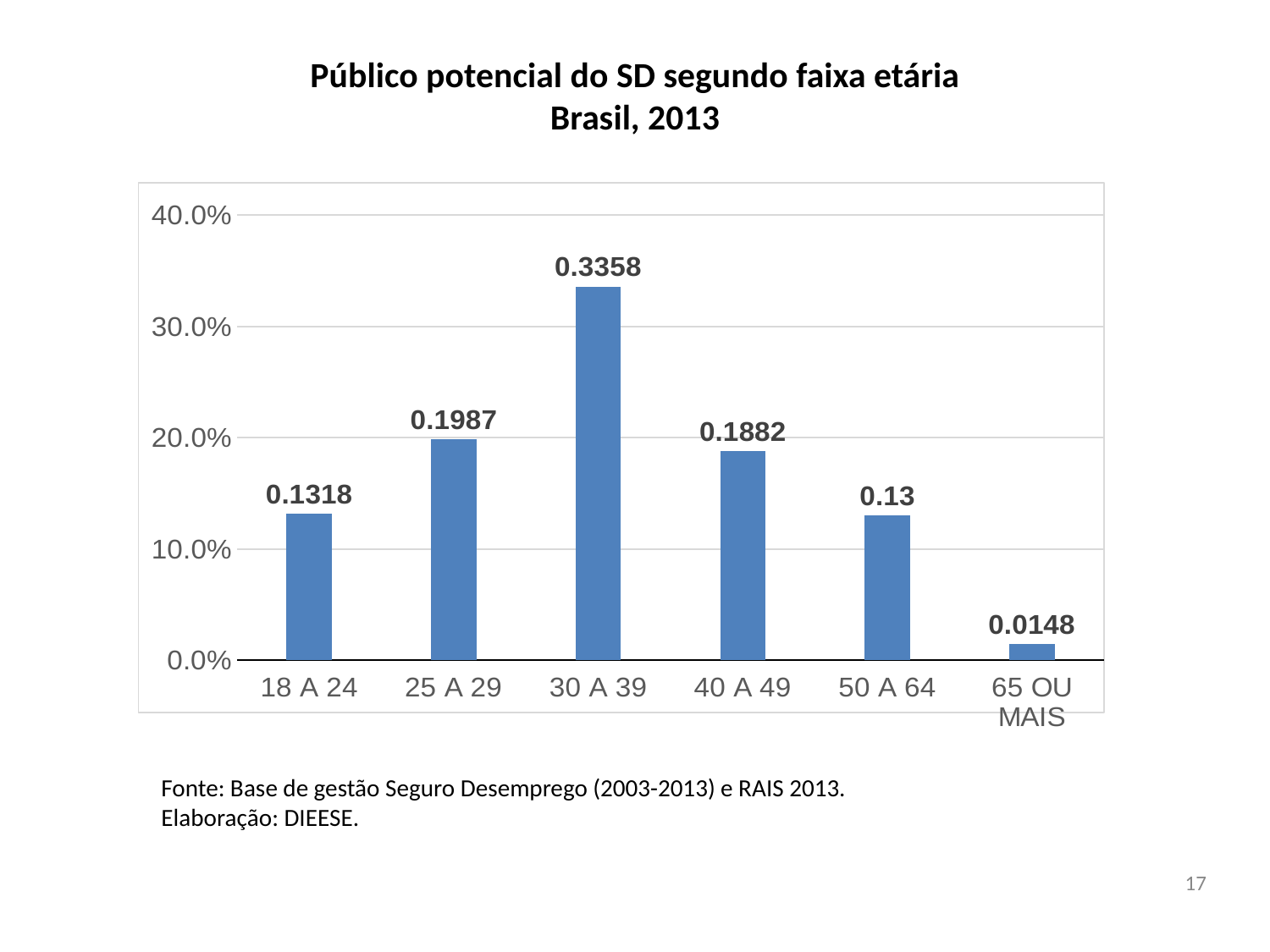
What kind of chart is shown on the slide? bar chart What is the difference between the values for 30 A 39 and 25 A 29? 0.1371 Which has a larger value, 40 A 49 or 50 A 64? 40 A 49 What is the value shown for the 30 A 39 age group? 0.3358 What is the title of the chart? Público potencial do SD segundo faixa etária Brasil, 2013 What is the value shown for the 50 A 64 age group? 0.13 Which age group has the lowest value? 65 OU MAIS Which age group has the highest value? 30 A 39 What is the value shown for the 25 A 29 age group? 0.1987 Is the value for 30 A 39 greater or less than 30.0%? greater How many age groups are shown on the chart? 6 What is the value shown for the 65 OU MAIS age group? 0.0148